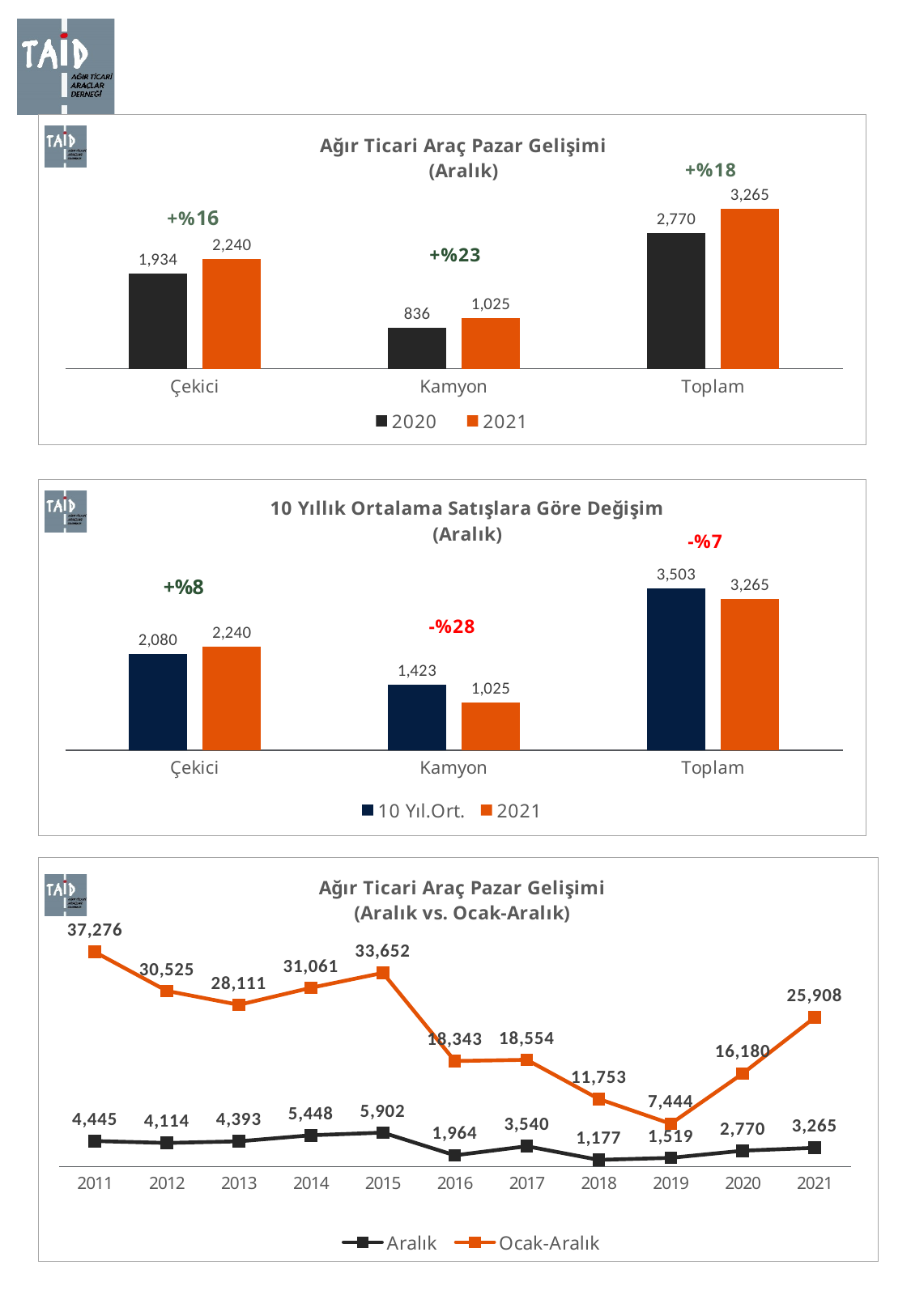
In the middle chart (10 Yıllık Ortalama Satışlara Göre Değişim (Aralık)), what is the 10 Yıl.Ort. value for Kamyon? 1,423 In the top chart (Ağır Ticari Araç Pazar Gelişimi (Aralık)), what percentage change is shown above the Toplam bars? +%18 How many series does the legend of the middle chart (10 Yıllık Ortalama Satışlara Göre Değişim (Aralık)) list? 2 How many years are shown on the x axis of the bottom chart (Ağır Ticari Araç Pazar Gelişimi (Aralık vs. Ocak-Aralık))? 11 In the bottom chart (Ağır Ticari Araç Pazar Gelişimi (Aralık vs. Ocak-Aralık)), which year has the highest Ocak-Aralık value? 2011 In the bottom chart (Ağır Ticari Araç Pazar Gelişimi (Aralık vs. Ocak-Aralık)), what is the Ocak-Aralık value for 2015? 33,652 In the bottom chart (Ağır Ticari Araç Pazar Gelişimi (Aralık vs. Ocak-Aralık)), which year has the lowest Aralık value? 2018 In the middle chart (10 Yıllık Ortalama Satışlara Göre Değişim (Aralık)), what is the difference between the 10 Yıl.Ort. and 2021 values for Toplam? 238 What type of chart is the top chart (Ağır Ticari Araç Pazar Gelişimi (Aralık))? Bar chart In the top chart (Ağır Ticari Araç Pazar Gelişimi (Aralık)), what is the 2021 value for Kamyon? 1,025 In the top chart (Ağır Ticari Araç Pazar Gelişimi (Aralık)), what is the difference between the 2021 and 2020 values for Çekici? 306 In the middle chart (10 Yıllık Ortalama Satışlara Göre Değişim (Aralık)), which is larger for Toplam: the 10 Yıl.Ort. value or the 2021 value? 10 Yıl.Ort.